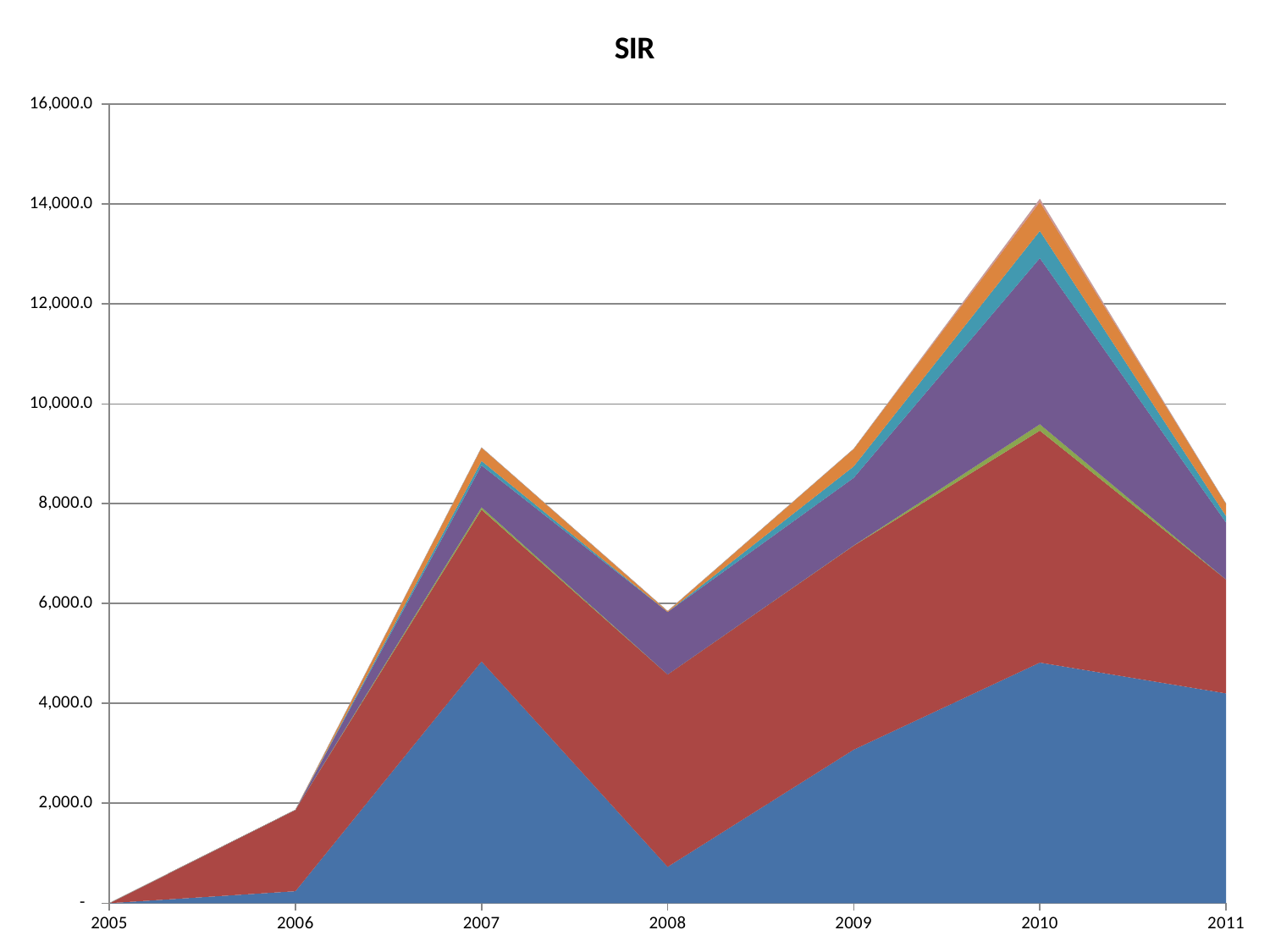
In which year is the total stacked value lowest? 2005 Is the total stacked value in 2010 greater or less than 12,000.0? greater Is the total stacked value in 2007 greater or less than 8,000.0? greater Does the total stacked value rise or fall from 2007 to 2008? fall In which year does the total stacked value reach its highest point? 2010 Is the value of the bottom (blue) series in 2008 greater or less than 2,000.0? less What kind of chart is shown on the slide? Stacked area chart What is the title of the chart? SIR What is the highest value shown on the y axis? 16,000.0 Which year has the larger total stacked value, 2007 or 2010? 2010 How many years are shown along the x axis? 7